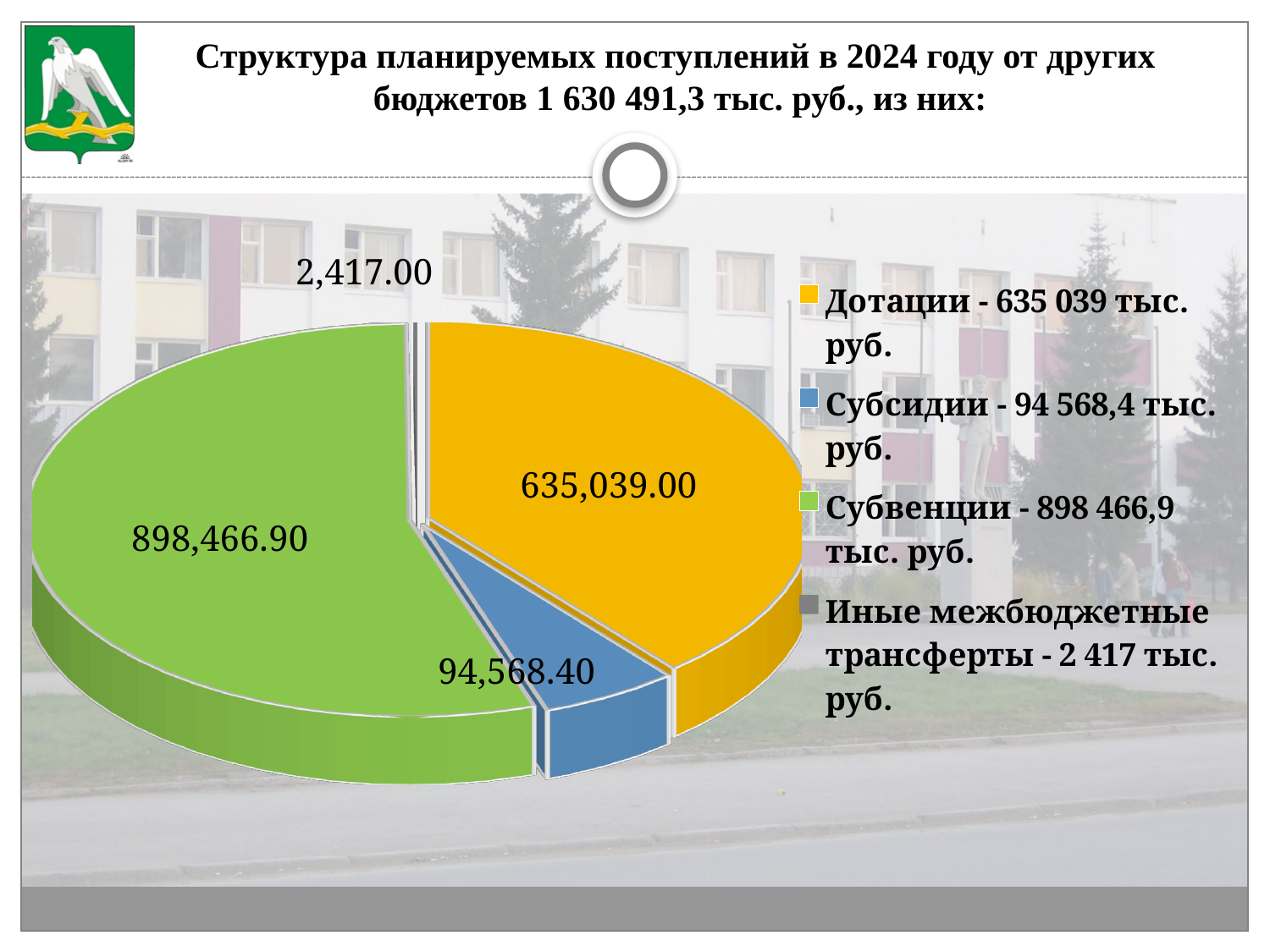
How many slices does the pie chart have? 4 Which category has the smallest slice of the pie? Иные межбюджетные трансферты Which category has the largest slice of the pie? Субвенции What is the difference between the Субвенции value and the Дотации value? 263,427.90 Which is larger, the Дотации slice or the Субсидии slice? Дотации What is the value shown for the Иные межбюджетные трансферты slice? 2,417.00 How many entries does the legend list? 4 What colour is the Субвенции slice in the pie chart? Green What is the value shown for the Дотации slice? 635,039.00 What kind of chart is shown on the slide? Pie chart What is the value shown for the Субсидии slice? 94,568.40 What is the value shown for the Субвенции slice? 898,466.90